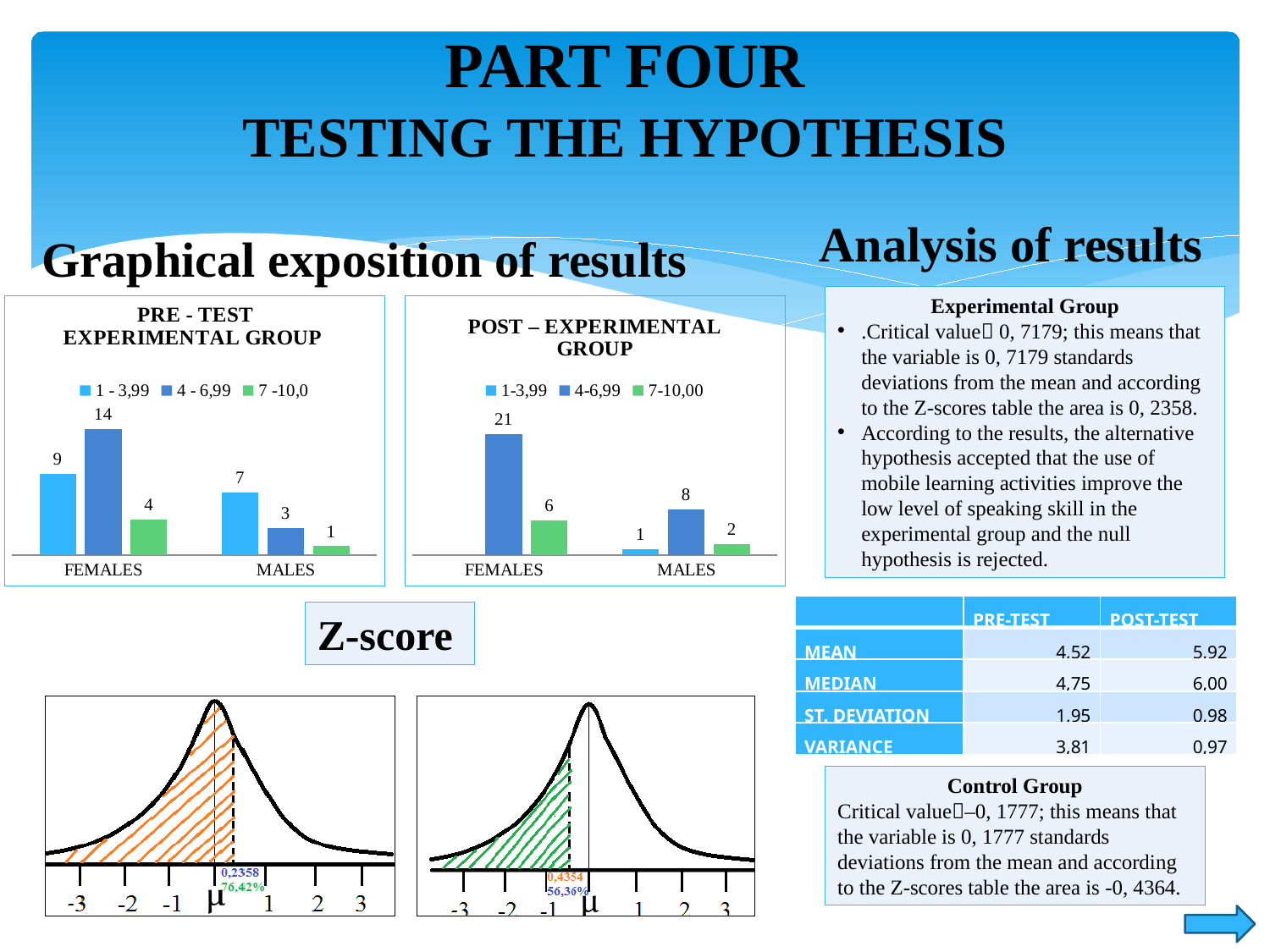
In the POST – EXPERIMENTAL GROUP chart, what is the value for MALES in the 7-10,00 series? 2 In the POST – EXPERIMENTAL GROUP chart, what is the value for FEMALES in the 4-6,99 series? 21 In the PRE - TEST EXPERIMENTAL GROUP chart, what is the difference between the 1 - 3,99 values for FEMALES and MALES? 2 In the PRE - TEST EXPERIMENTAL GROUP chart, what is the value for MALES in the 7 -10,0 series? 1 In the POST – EXPERIMENTAL GROUP chart, which series has the lowest value for MALES? 1-3,99 How many categories are shown on the x axis of the PRE - TEST EXPERIMENTAL GROUP chart? 2 In the PRE - TEST EXPERIMENTAL GROUP chart, which series has the highest value for FEMALES? 4 - 6,99 How many series does the legend of the POST – EXPERIMENTAL GROUP chart list? 3 In the PRE - TEST EXPERIMENTAL GROUP chart, which is larger: the 7 -10,0 value for FEMALES or for MALES? FEMALES In the PRE - TEST EXPERIMENTAL GROUP chart, what is the value for FEMALES in the 4 - 6,99 series? 14 In the POST – EXPERIMENTAL GROUP chart, what is the difference between the 4-6,99 values for FEMALES and MALES? 13 What kind of chart is the PRE - TEST EXPERIMENTAL GROUP chart? Bar chart